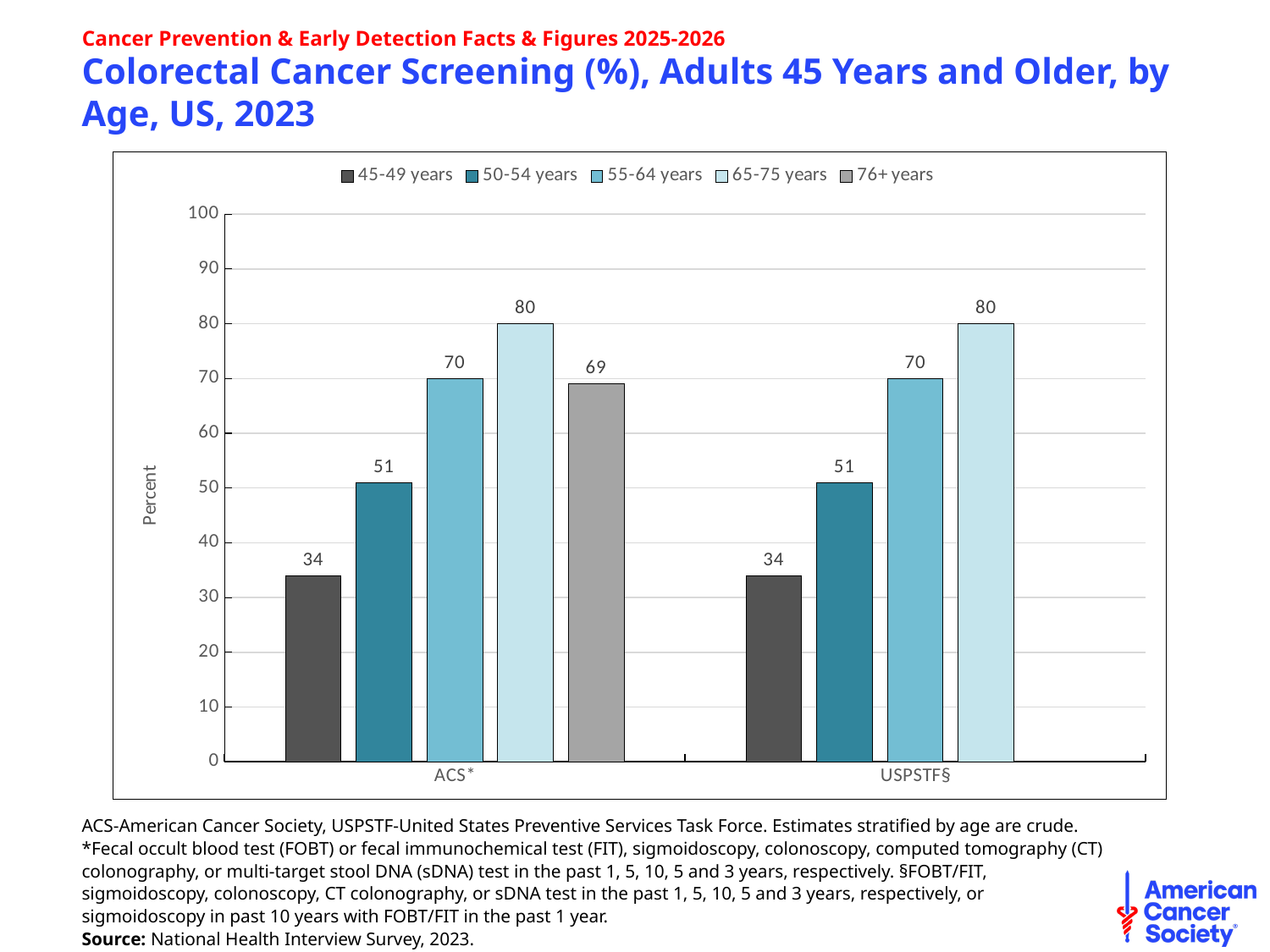
What is the label of the y axis? Percent Which age group has the highest screening percentage under the ACS* guideline? 65-75 years How many series does the legend list? 5 What is the screening percentage for the 76+ years group under the ACS* guideline? 69 What is the screening percentage for the 65-75 years group under the USPSTF§ guideline? 80 Which age group has the lowest screening percentage under the USPSTF§ guideline? 45-49 years How many guideline categories are shown on the x axis? 2 What is the difference between the screening percentages for the 65-75 years and 45-49 years groups under the ACS* guideline? 46 What is the colorectal cancer screening percentage for adults aged 45-49 years under the ACS* guideline? 34 Which age group has no bar shown for the USPSTF§ guideline? 76+ years Under the ACS* guideline, which has a higher screening percentage: the 55-64 years group or the 76+ years group? 55-64 years What kind of chart is shown on the slide? Bar chart